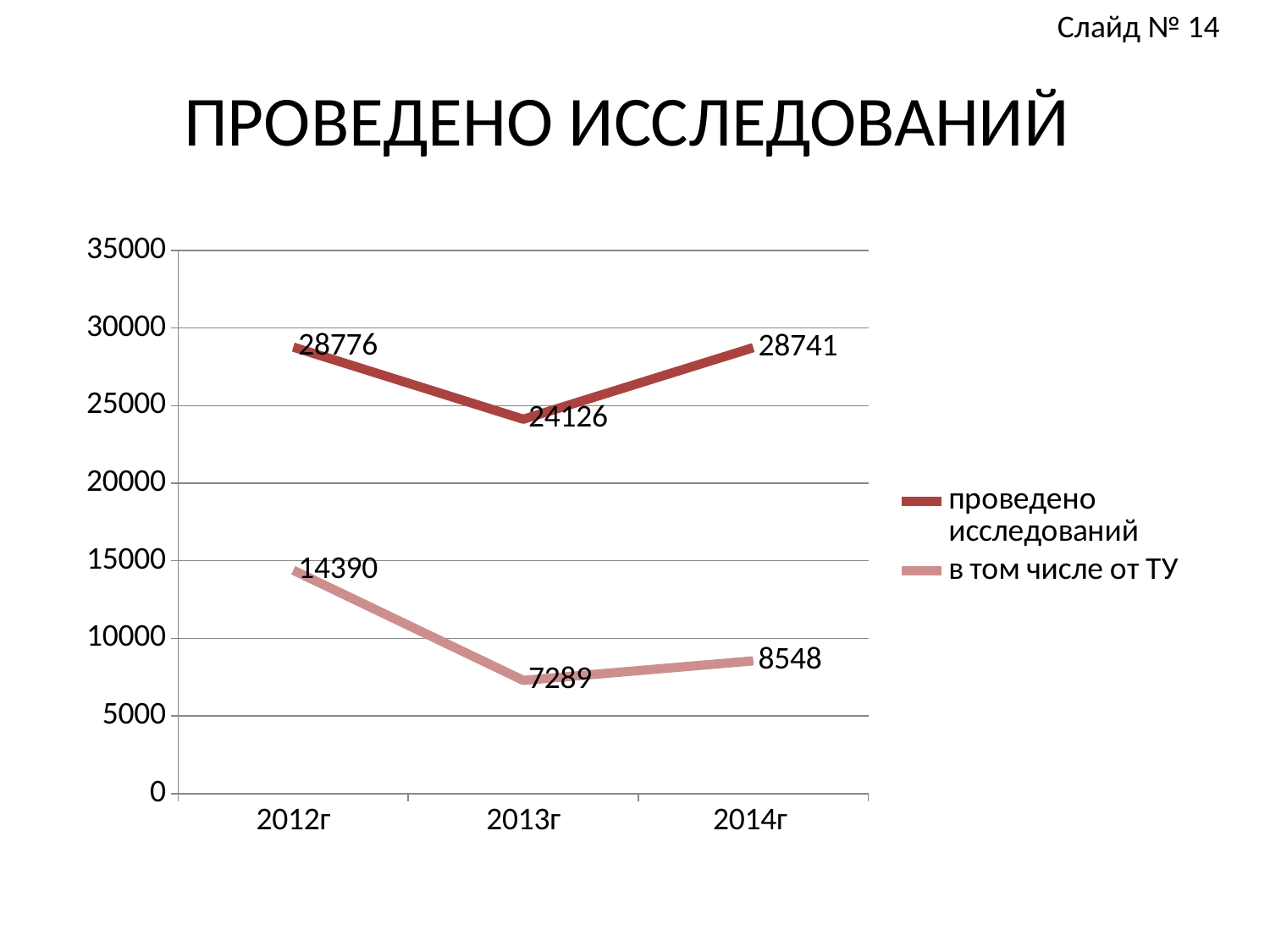
In which year is "проведено исследований" lowest? 2013г What is the value of "проведено исследований" for 2013г? 24126 What is the value of "в том числе от ТУ" for 2012г? 14390 What is the difference between "в том числе от ТУ" in 2014г and 2013г? 1259 Does "в том числе от ТУ" rise or fall from 2012г to 2013г? fall Which is larger: "проведено исследований" in 2012г or in 2014г? 2012г In which year is "в том числе от ТУ" highest? 2012г How many series does the legend list? 2 What is the difference between "проведено исследований" in 2012г and 2013г? 4650 What type of chart is shown on the slide? line chart What is the value of "в том числе от ТУ" for 2014г? 8548 How many years are shown on the x axis? 3